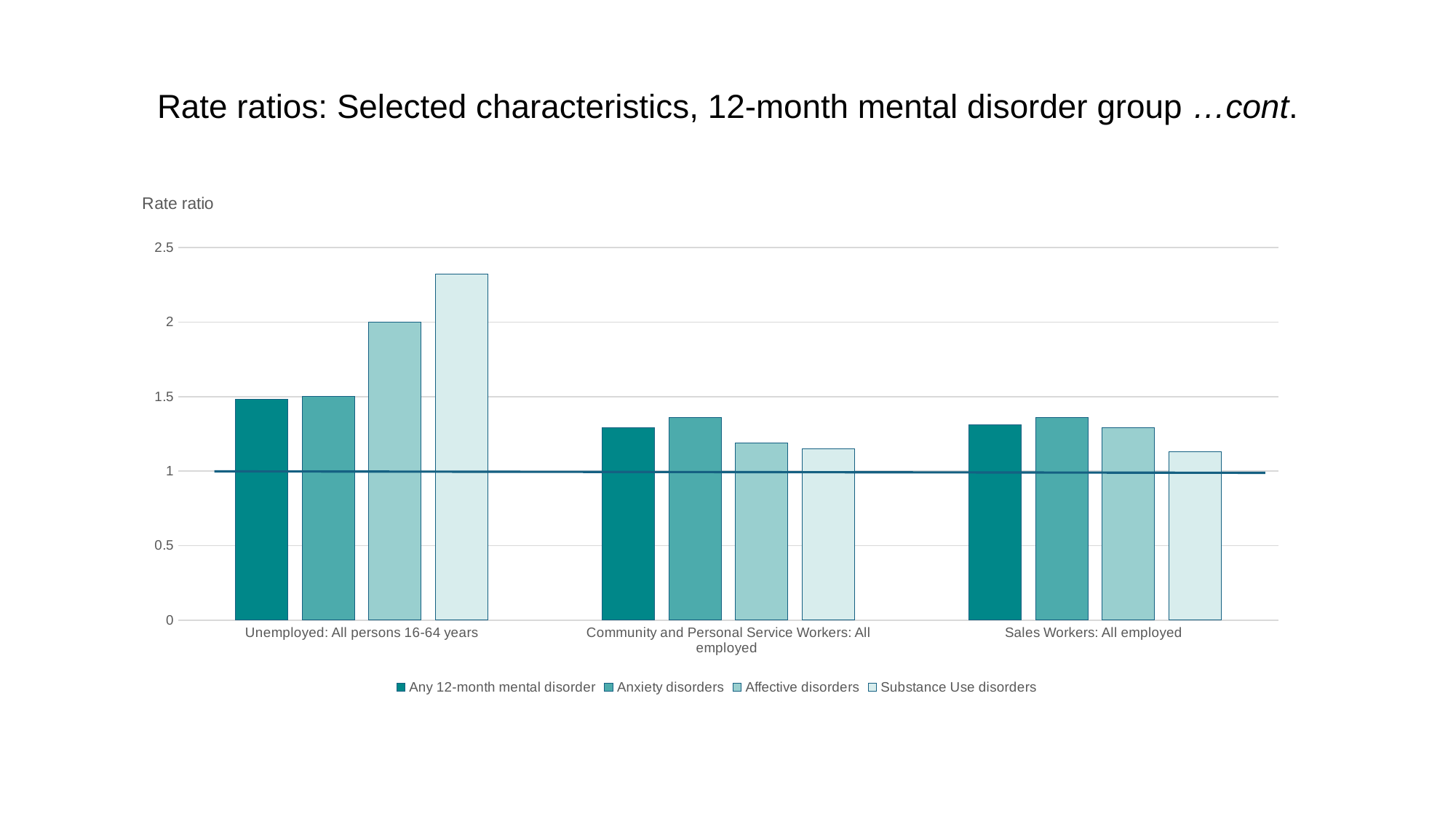
Is the value for Substance Use disorders in the Unemployed: All persons 16-64 years category greater or less than 2? greater What kind of chart is shown on the slide? bar chart Which series has the highest bar for Unemployed: All persons 16-64 years? Substance Use disorders How many series does the legend list? 4 Which is larger: Substance Use disorders for Unemployed: All persons 16-64 years or Substance Use disorders for Sales Workers: All employed? Unemployed: All persons 16-64 years Is the value for Anxiety disorders in the Community and Personal Service Workers: All employed category greater or less than 1? greater Which series has the lowest bar for Sales Workers: All employed? Substance Use disorders Which is larger: Affective disorders for Unemployed: All persons 16-64 years or Affective disorders for Community and Personal Service Workers: All employed? Unemployed: All persons 16-64 years Is the value for Substance Use disorders in the Sales Workers: All employed category greater or less than 1.5? less How many categories are shown on the x axis? 3 What is the label on the vertical axis of the chart? Rate ratio